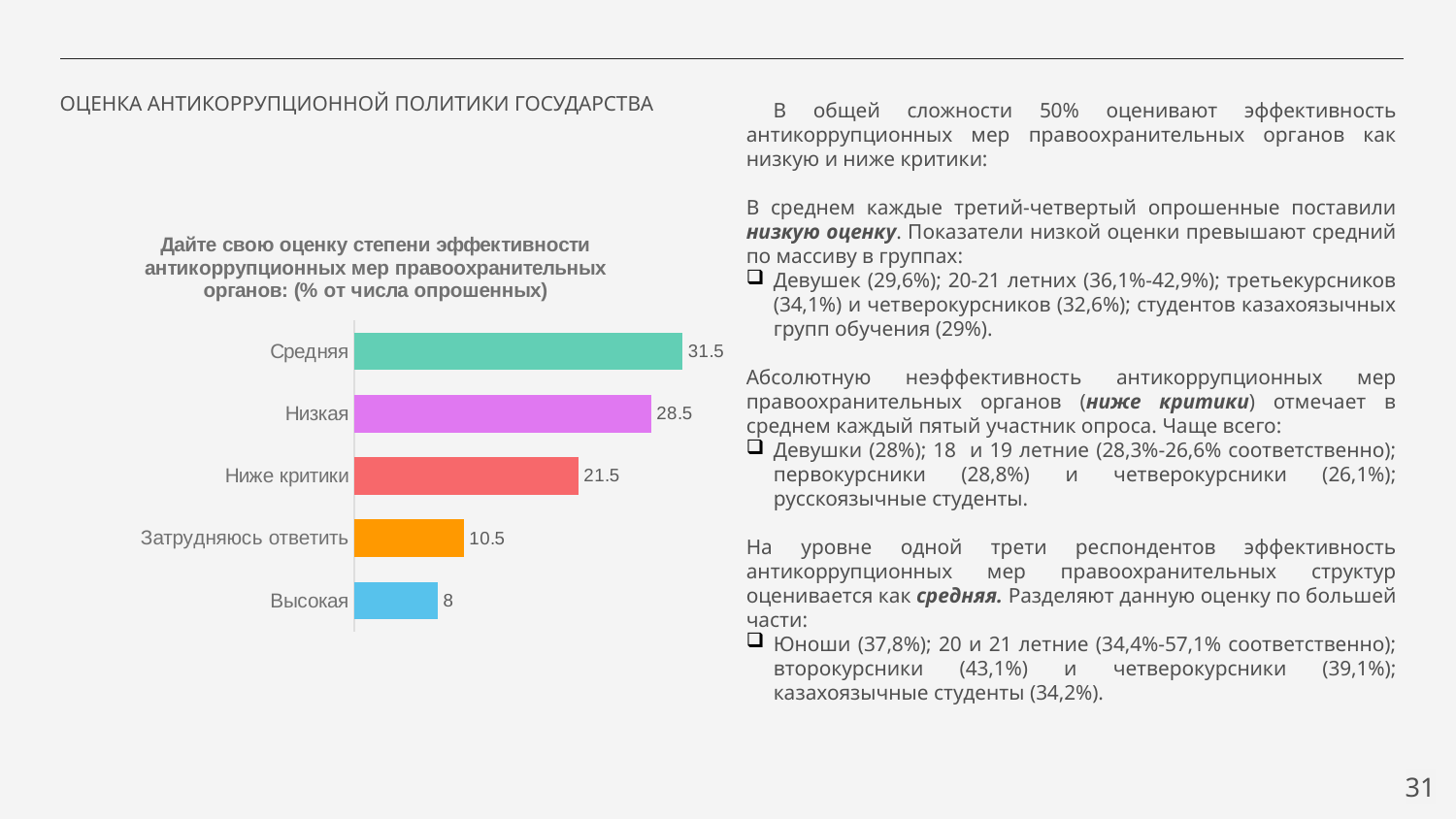
What value is shown for the "Средняя" category? 31.5 How many categories are shown in the chart? 5 What is the difference between the values for "Средняя" and "Низкая"? 3 What value is shown for the "Высокая" category? 8 What value is shown for the "Затрудняюсь ответить" category? 10.5 Which category has the lowest value? Высокая What value is shown for the "Низкая" category? 28.5 What is the difference between the values for "Ниже критики" and "Высокая"? 13.5 Which category has the highest value? Средняя What value is shown for the "Ниже критики" category? 21.5 What type of chart is shown on the slide? Bar chart Which is larger, the value for "Низкая" or the value for "Ниже критики"? Низкая